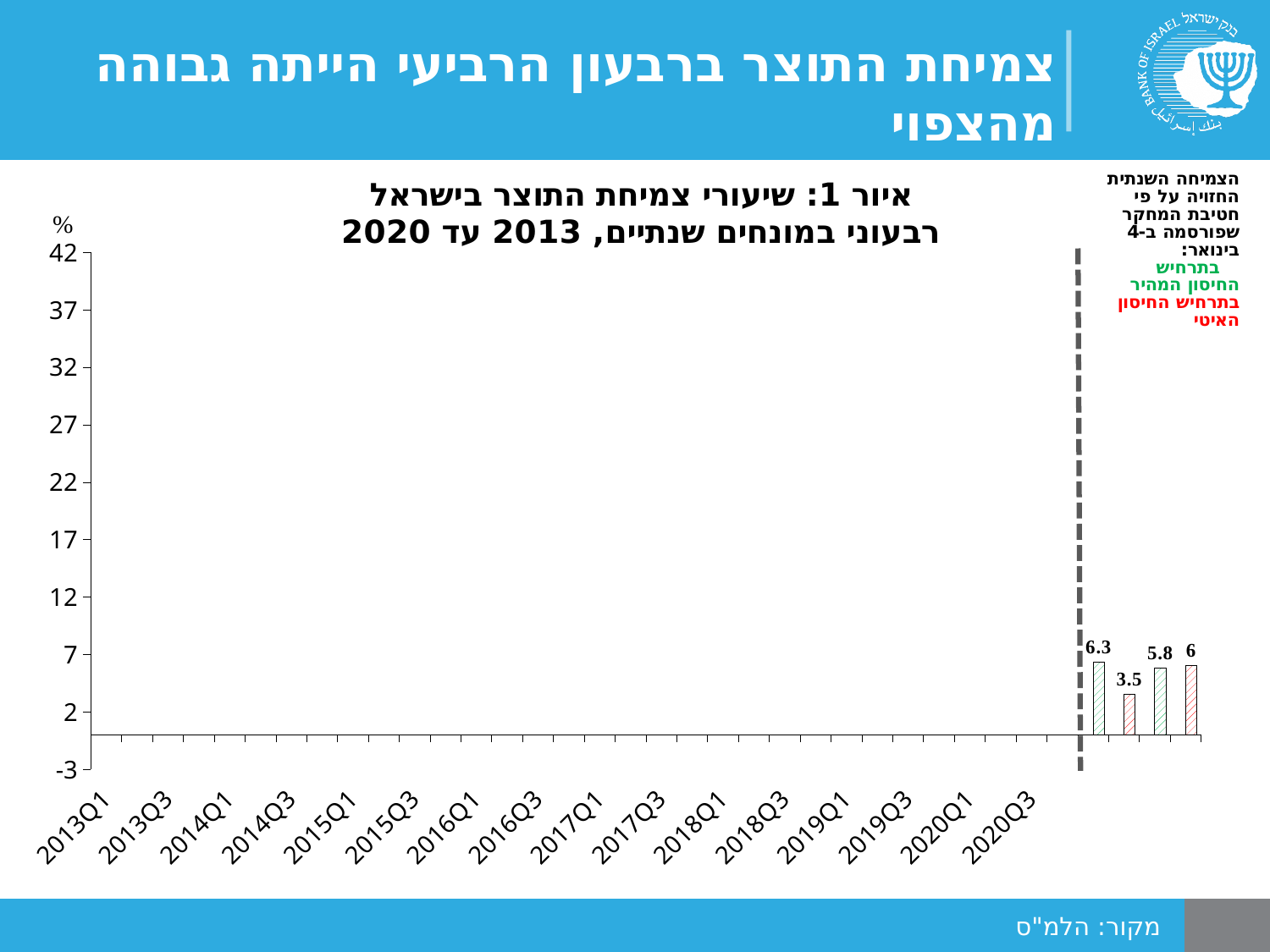
Is the value of the bar labeled 3.5 greater or less than 7? less What is the highest value printed as a data label on the chart? 6.3 What is the value of the second labeled bar to the right of the dashed line? 3.5 What is the value of the first (leftmost) labeled bar to the right of the dashed line? 6.3 What type of chart is shown on the slide? bar chart Which is larger: the bar labeled 5.8 or the bar labeled 6? 6 Is the value of the bar labeled 6.3 greater or less than 2? greater What is the highest tick value shown on the y-axis? 42 How many bars with data labels appear to the right of the dashed vertical line? 4 What unit is shown at the top of the y-axis? % What is the lowest value printed as a data label on the chart? 3.5 What is the difference between the highest labeled bar (6.3) and the lowest labeled bar (3.5)? 2.8